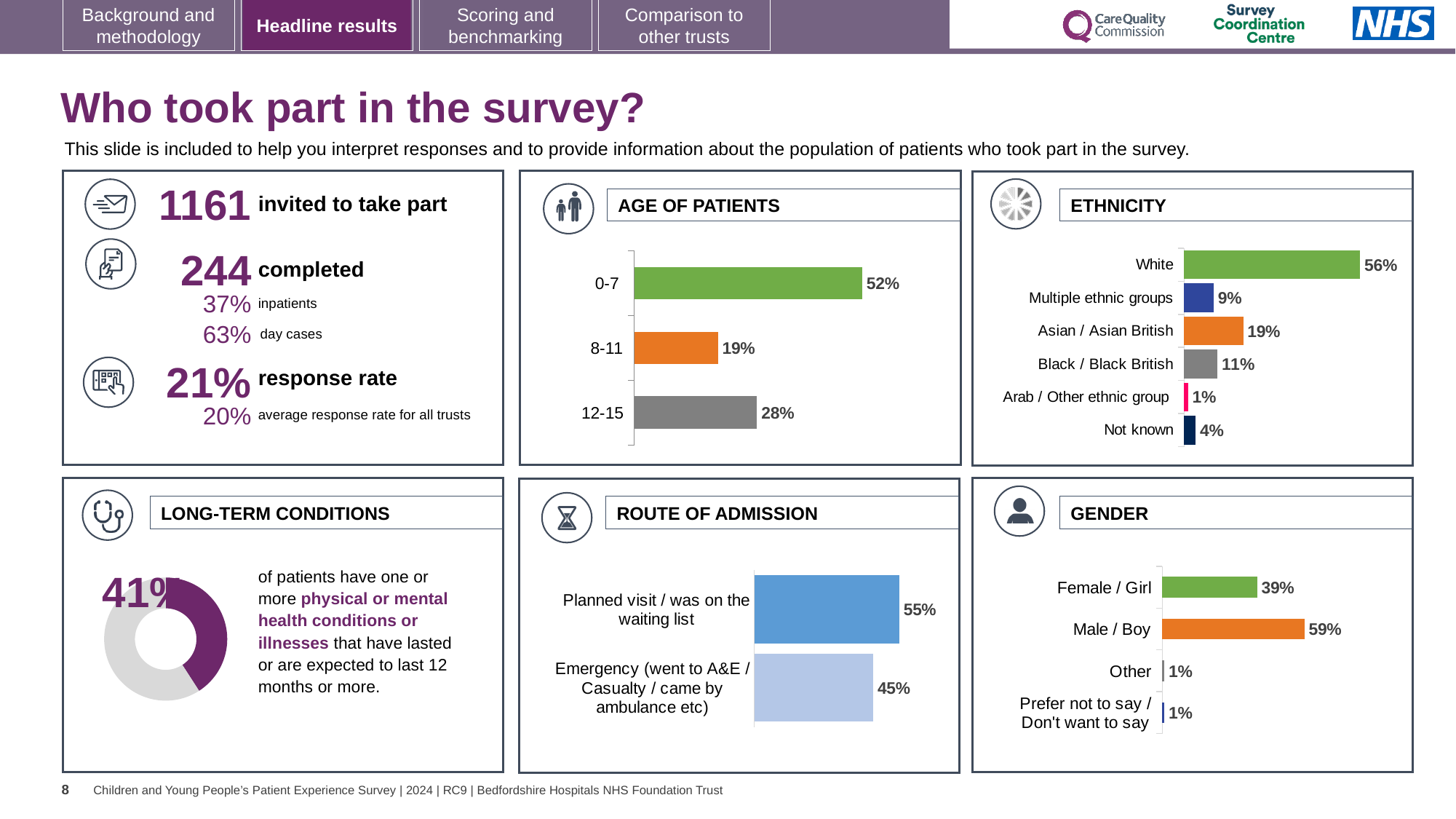
In the ETHNICITY chart, what is the value for Asian / Asian British? 19% In the AGE OF PATIENTS chart, what percentage of patients are aged 0-7? 52% In the ROUTE OF ADMISSION chart, what is the value for Emergency (went to A&E / Casualty / came by ambulance etc)? 45% In the ETHNICITY chart, what is the difference between the White and Black / Black British values? 45% In the AGE OF PATIENTS chart, which age group has the lowest percentage? 8-11 In the ETHNICITY chart, which category has the highest percentage? White How many categories are shown in the ETHNICITY chart? 6 In the LONG-TERM CONDITIONS chart, what percentage of patients have one or more long-term conditions? 41% In the GENDER chart, what is the difference between Male / Boy and Female / Girl? 20% In the GENDER chart, what is the value for Male / Boy? 59% In the ROUTE OF ADMISSION chart, which is larger: Planned visit / was on the waiting list or Emergency? Planned visit / was on the waiting list What kind of chart is the LONG-TERM CONDITIONS chart? Doughnut chart